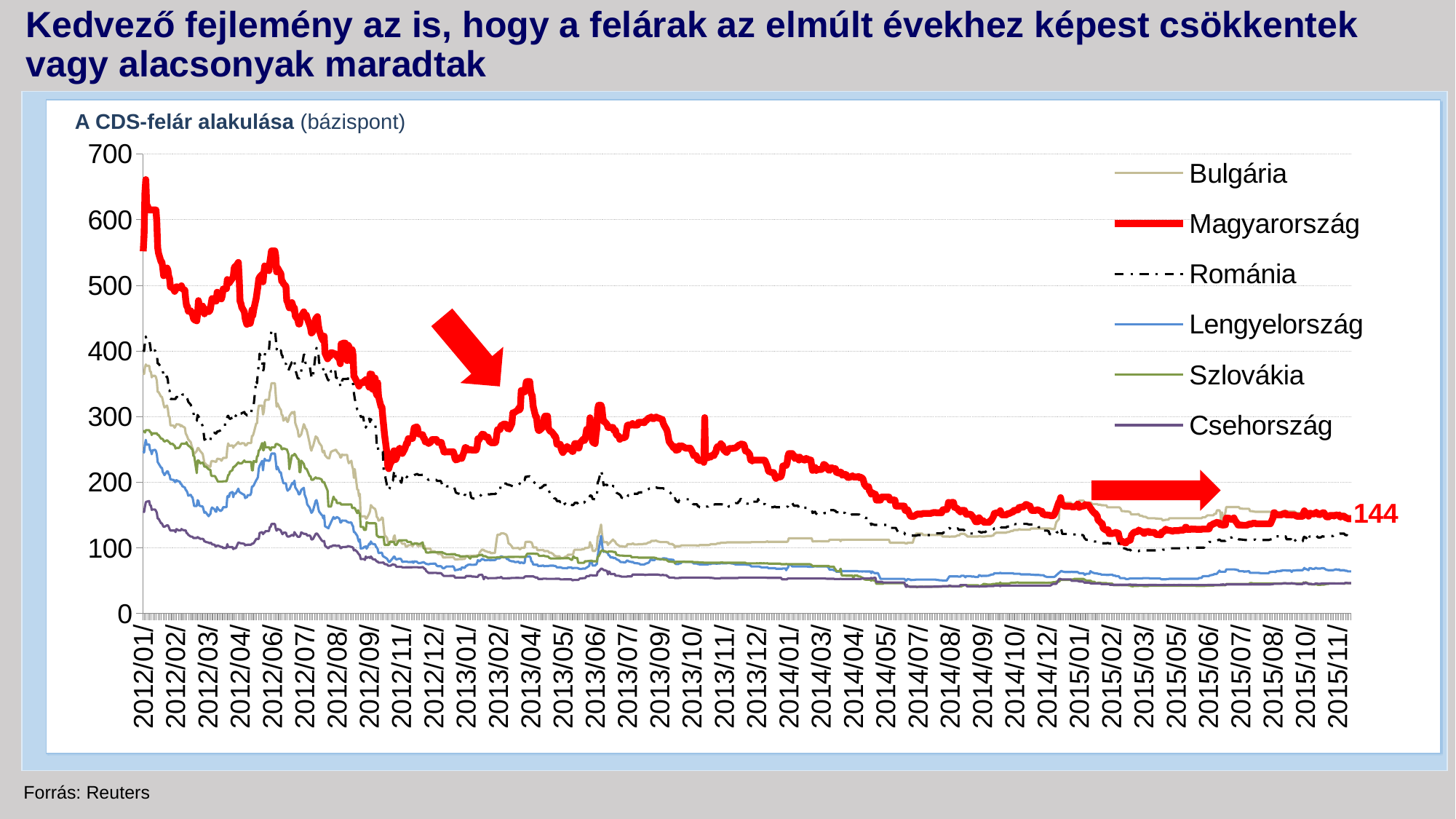
Does the Magyarország line rise or fall overall from 2012/01 to 2015/11? fall Is the value for Csehország at 2015/11 greater or less than 100? less How many series does the legend list? 6 At 2012/06, which is larger: Bulgária or Lengyelország? Bulgária Is the value for Magyarország at 2012/01 greater or less than 500? greater In what unit are the values of the chart expressed, according to the chart title? bázispont Is the value for Lengyelország at 2015/11 greater or less than 100? less What kind of chart is shown on the slide? line chart Which series has the highest value at 2012/01? Magyarország Which series has the lowest value at 2012/01? Csehország At 2015/11, which is larger: Magyarország or Lengyelország? Magyarország What is the last labelled value for Magyarország at the right end of the chart? 144